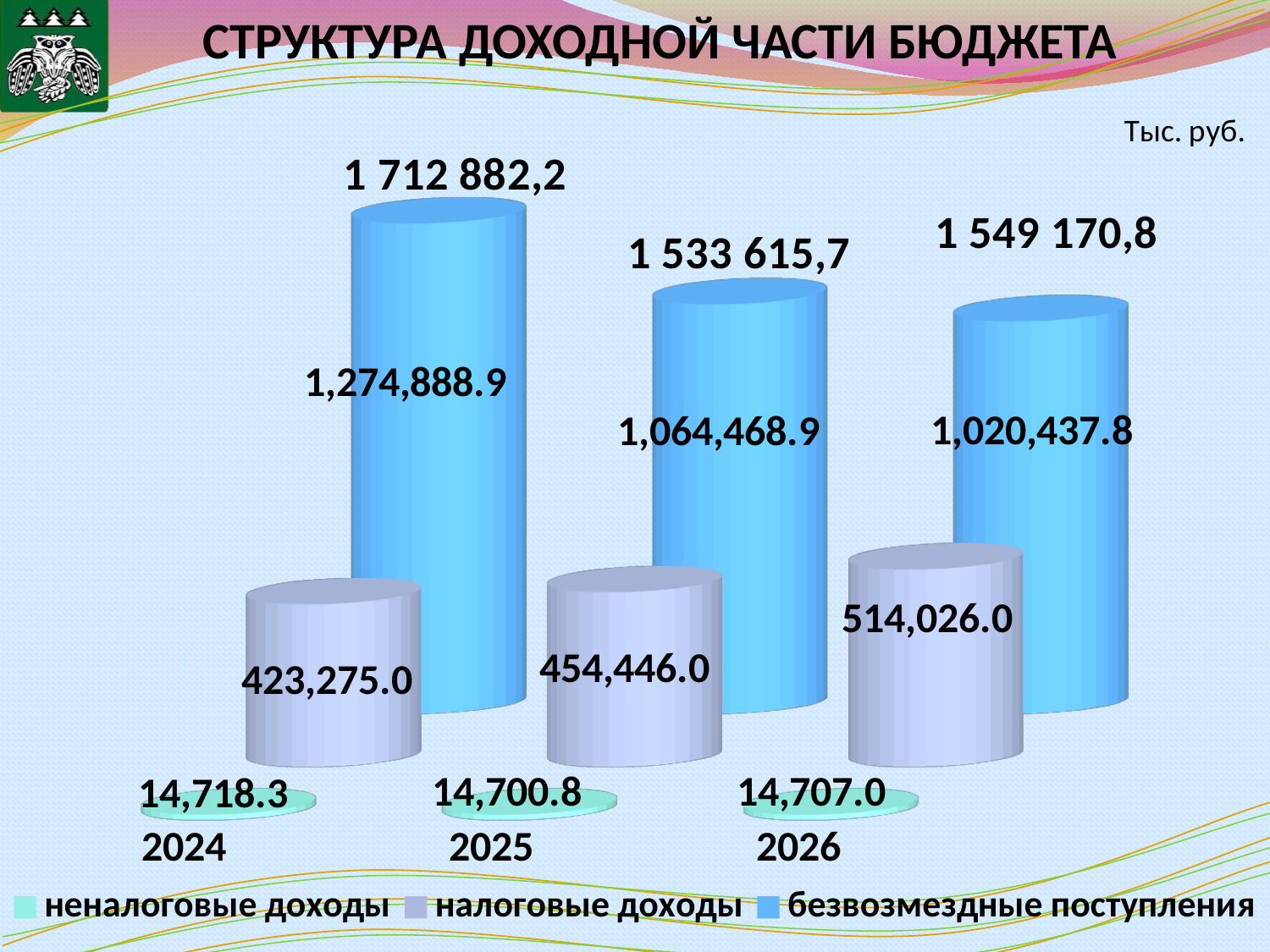
What is the value of налоговые доходы for 2026? 514,026.0 What total is printed above the 2025 bars? 1 533 615,7 How many years are shown on the x axis? 3 What is the value of неналоговые доходы for 2025? 14,700.8 In which year are безвозмездные поступления the highest? 2024 What is the difference between безвозмездные поступления in 2024 and in 2025? 210,420.0 How many series does the legend list? 3 What is the difference between налоговые доходы in 2026 and in 2024? 90,751.0 What is the value of безвозмездные поступления for 2024? 1,274,888.9 Do налоговые доходы rise or fall from 2024 to 2026? rise Which is larger in 2026: налоговые доходы or безвозмездные поступления? безвозмездные поступления In which year are налоговые доходы the lowest? 2024